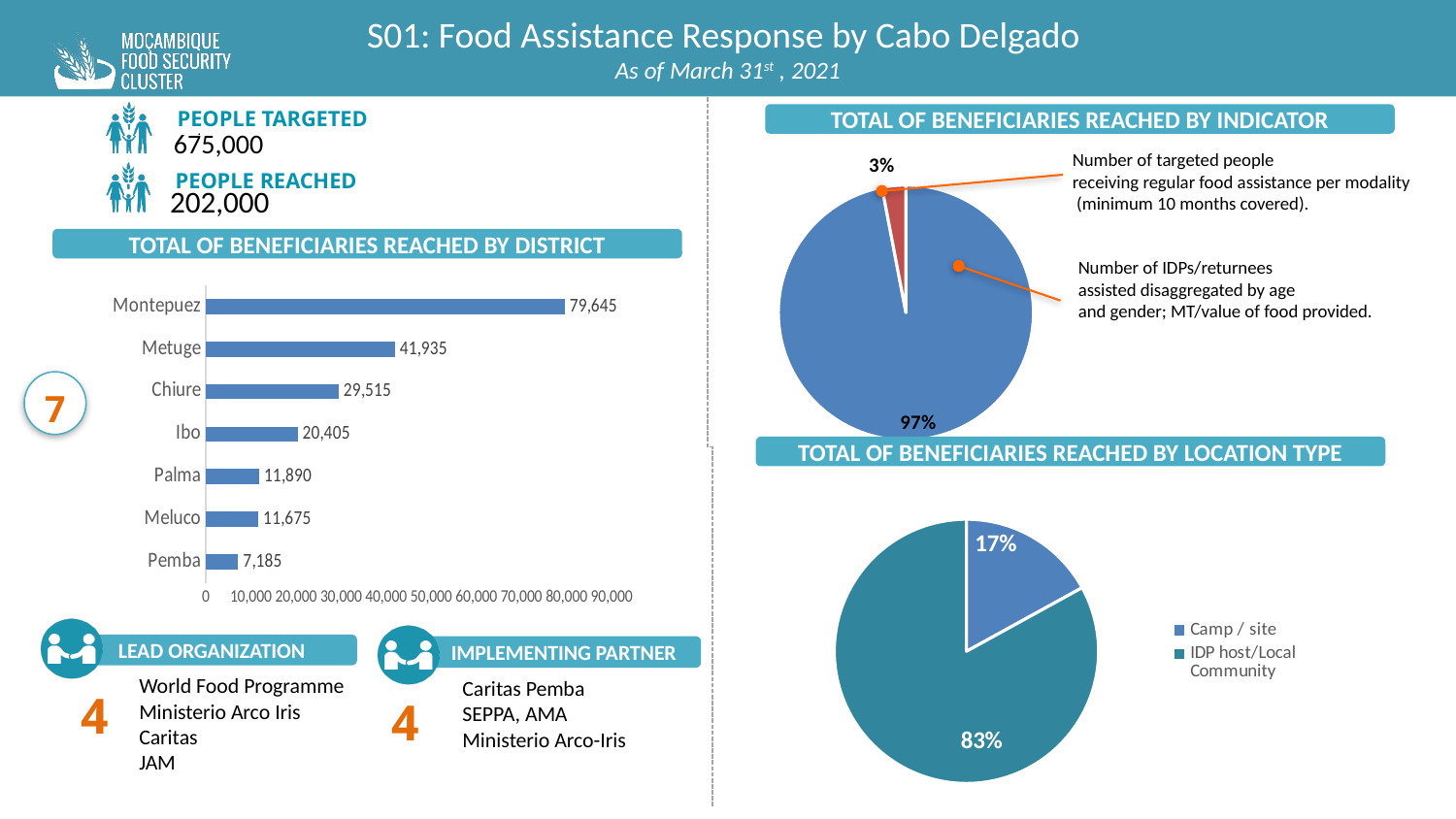
How many entries does the legend of the 'Total of beneficiaries reached by location type' pie chart list? 2 In the 'Total of beneficiaries reached by indicator' pie chart, what share is shown for the number of targeted people receiving regular food assistance per modality? 3% How many districts are shown in the 'Total of beneficiaries reached by district' chart? 7 In the 'Total of beneficiaries reached by district' chart, what is the difference between the values for Metuge and Chiure? 12,420 What type of chart is the 'Total of beneficiaries reached by district' chart? Bar chart In the 'Total of beneficiaries reached by district' chart, how many beneficiaries were reached in Montepuez? 79,645 In the 'Total of beneficiaries reached by district' chart, which district has more beneficiaries reached, Palma or Meluco? Palma In the 'Total of beneficiaries reached by indicator' pie chart, what share is shown for the number of IDPs/returnees assisted disaggregated by age and gender? 97% In the 'Total of beneficiaries reached by district' chart, which district has the lowest number of beneficiaries reached? Pemba In the 'Total of beneficiaries reached by location type' pie chart, what share is shown for Camp / site? 17% In the 'Total of beneficiaries reached by district' chart, how many beneficiaries were reached in Ibo? 20,405 In the 'Total of beneficiaries reached by district' chart, which district has the highest number of beneficiaries reached? Montepuez